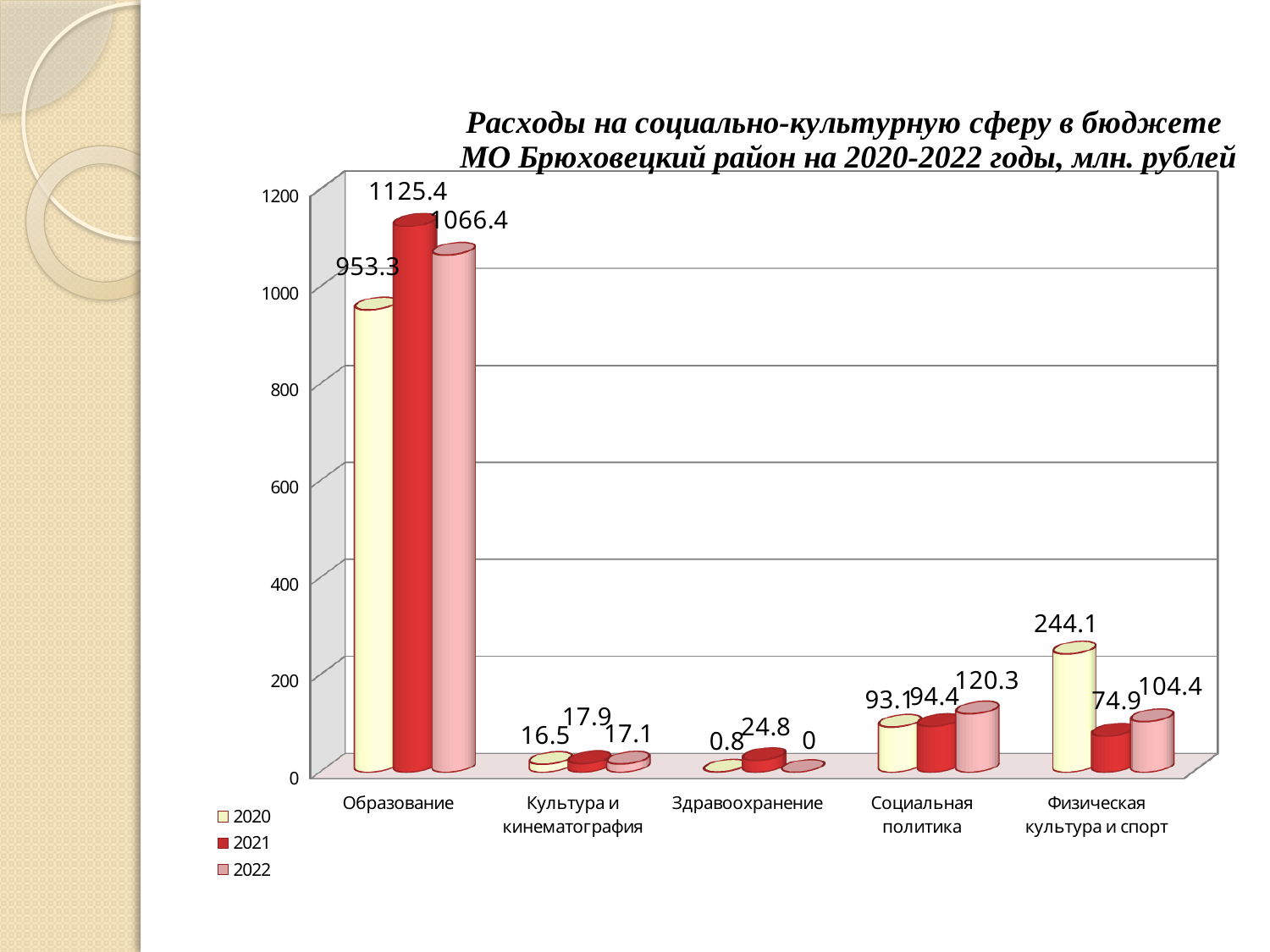
What is the value for Образование in the 2021 series? 1125.4 Which is larger for Физическая культура и спорт: the 2020 value or the 2022 value? 2020 How many categories are shown on the x axis? 5 How many series does the legend list? 3 Which series is shown in dark red in the legend? 2021 What kind of chart is shown on the slide? bar chart What is the value for Физическая культура и спорт in the 2020 series? 244.1 What is the difference between the 2021 and 2020 values for Образование? 172.1 Which category has the highest value in the 2020 series? Образование Which category has the lowest value in the 2021 series? Культура и кинематография What is the value for Здравоохранение in the 2022 series? 0 What is the value for Социальная политика in the 2022 series? 120.3